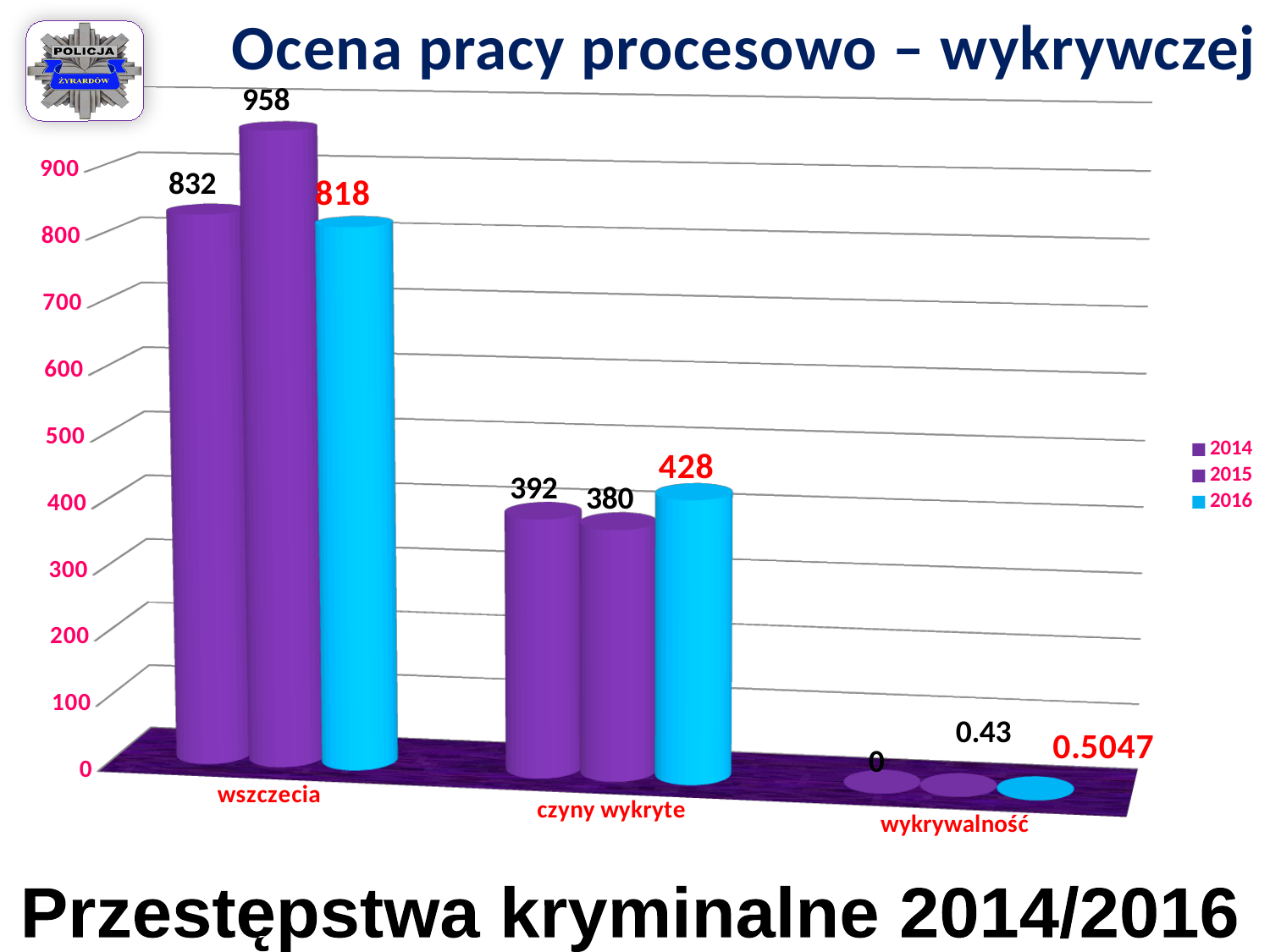
What is the value for 2016 in the czyny wykryte category? 428 What is the difference between the 2016 and 2014 values in the czyny wykryte category? 36 What is the value for 2016 in the wykrywalność category? 0.5047 What is the value for 2015 in the wszczecia category? 958 Which is larger: the 2014 value or the 2016 value in the wszczecia category? 2014 What kind of chart is shown on the slide? bar chart Which year has the lowest value in the czyny wykryte category? 2015 How many series does the legend list? 3 How many categories are shown on the x axis? 3 What is the difference between the 2015 and 2016 values in the wszczecia category? 140 What is the value for 2014 in the wszczecia category? 832 Which year has the highest value in the wszczecia category? 2015